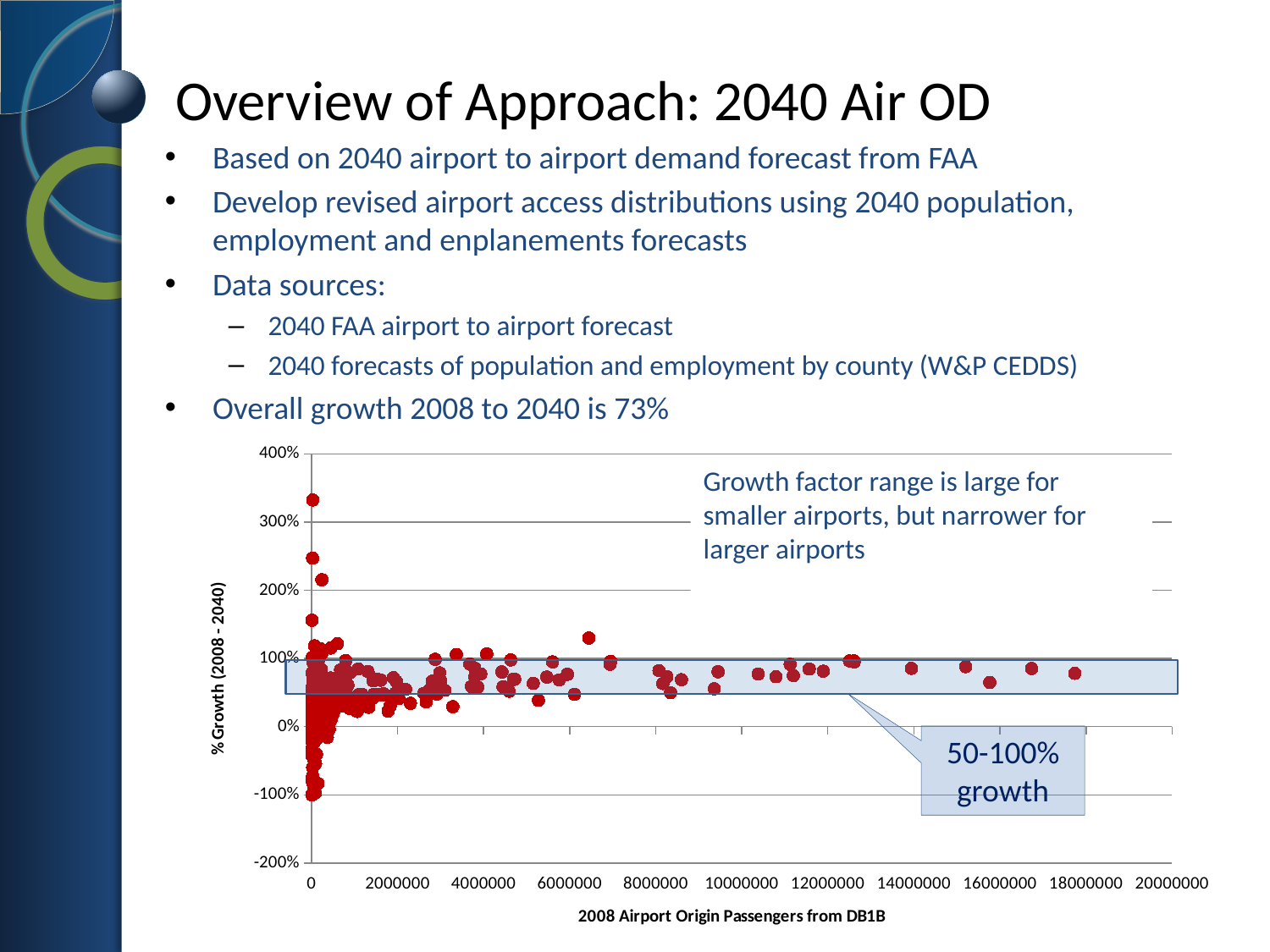
Is the growth value for the airport with about 18,000,000 origin passengers greater or less than 0%? greater Is the highest plotted growth value greater or less than 300%? greater What growth range does the callout on the chart highlight? 50-100% growth What is the maximum value shown on the horizontal axis of the chart? 20000000 What is the maximum value shown on the vertical axis of the chart? 400% Is the growth value for the airport with about 18,000,000 origin passengers greater or less than 100%? less What is the label on the vertical axis of the chart? % Growth (2008 - 2040) What kind of chart is shown on the slide? Scatter chart Does the spread of growth values widen or narrow as 2008 airport origin passengers increase along the x axis? narrow